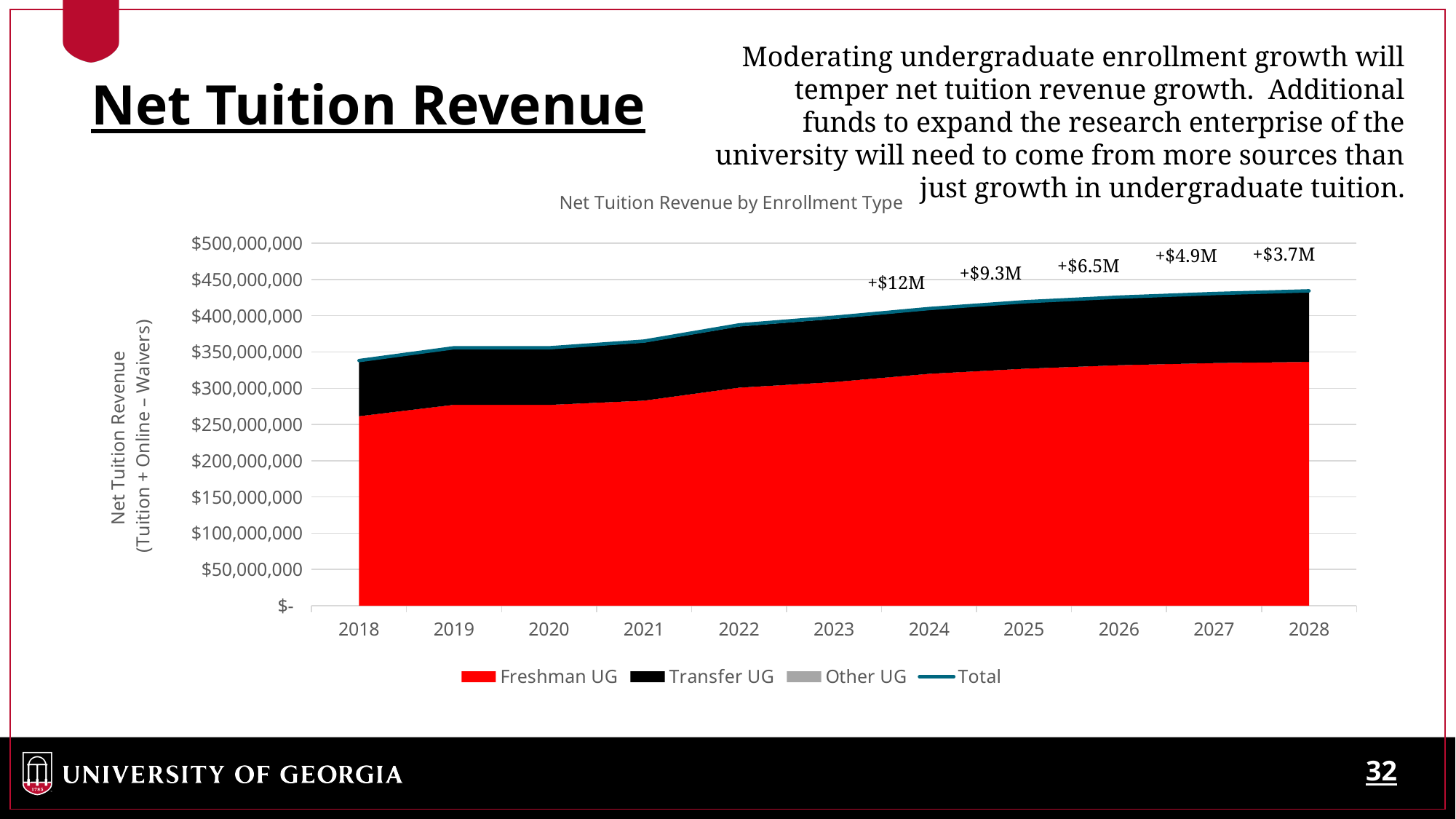
What increase is annotated above the year 2024 on the chart? +$12M What kind of chart is shown on the slide? Stacked area chart with a total line Is the Total value for 2028 greater or less than $400,000,000? greater What is the title of the chart? Net Tuition Revenue by Enrollment Type How many years are shown along the x axis of the chart? 11 What increase is annotated above the year 2028 on the chart? +$3.7M How many series does the chart legend list? 4 Is the Total value for 2018 greater or less than $350,000,000? less Which year has the largest annotated increase on the chart? 2024 Does the Total line rise or fall from 2018 to 2028? Rises What increase is annotated above the year 2026 on the chart? +$6.5M Which series is shown in red on the chart? Freshman UG